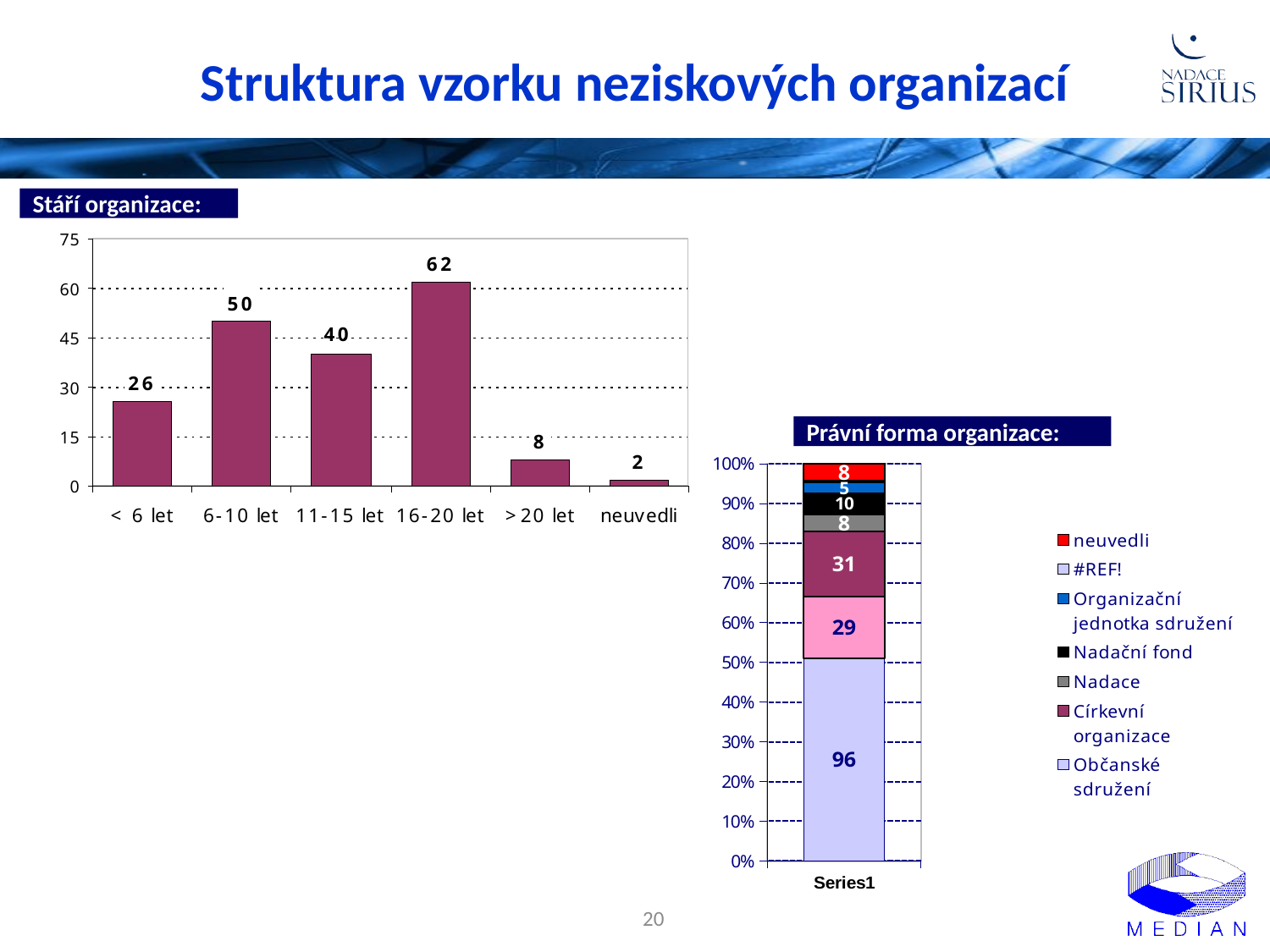
In the 'Stáří organizace' chart, what is the value for '< 6 let'? 26 What kind of chart is the 'Stáří organizace' chart? bar chart In the 'Stáří organizace' chart, which category has the highest value? 16-20 let In the 'Právní forma organizace' chart, what is the value for 'Církevní organizace'? 31 How many entries does the legend of the 'Právní forma organizace' chart list? 7 How many categories are shown on the x axis of the 'Stáří organizace' chart? 6 In the 'Stáří organizace' chart, which category has the lowest value? neuvedli In the 'Stáří organizace' chart, what is the value for '16-20 let'? 62 In the 'Stáří organizace' chart, which is larger: the value for '6-10 let' or the value for '> 20 let'? 6-10 let In the 'Stáří organizace' chart, what is the difference between the values for '6-10 let' and '11-15 let'? 10 In the 'Právní forma organizace' chart, what is the value for 'Občanské sdružení'? 96